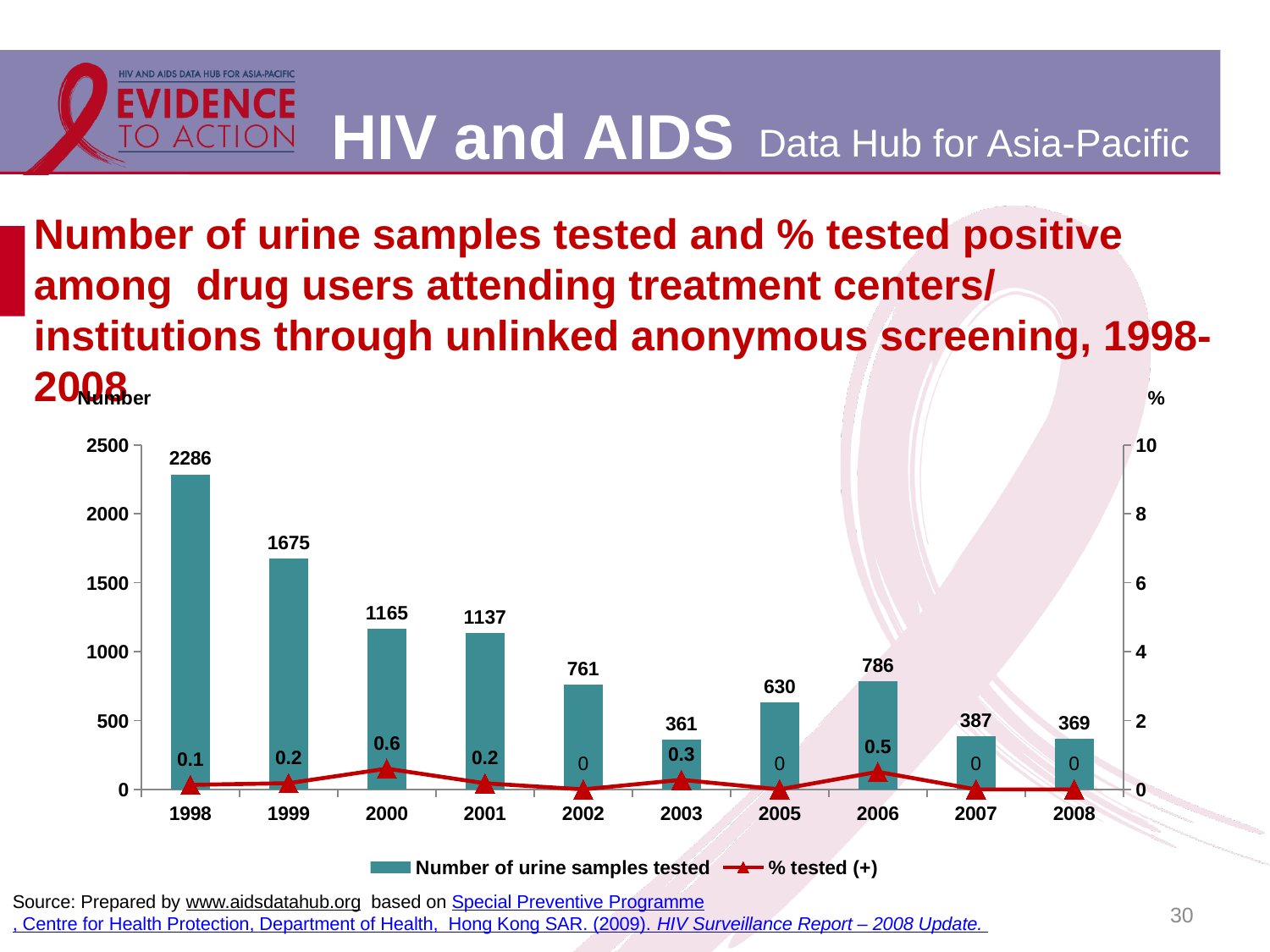
How many urine samples were tested in 1998? 2286 Which year had the highest % tested positive? 2000 What was the % tested positive in 2000? 0.6 How many series does the legend list? 2 Which year had the lowest number of urine samples tested? 2003 Which year had more urine samples tested, 2005 or 2006? 2006 How many urine samples were tested in 2006? 786 What is the difference between the number of urine samples tested in 1998 and in 1999? 611 What kind of chart is used to show the number of urine samples tested? Bar chart What is the label of the right-hand vertical axis? % Which year had the highest number of urine samples tested? 1998 How many years are shown on the x axis? 10